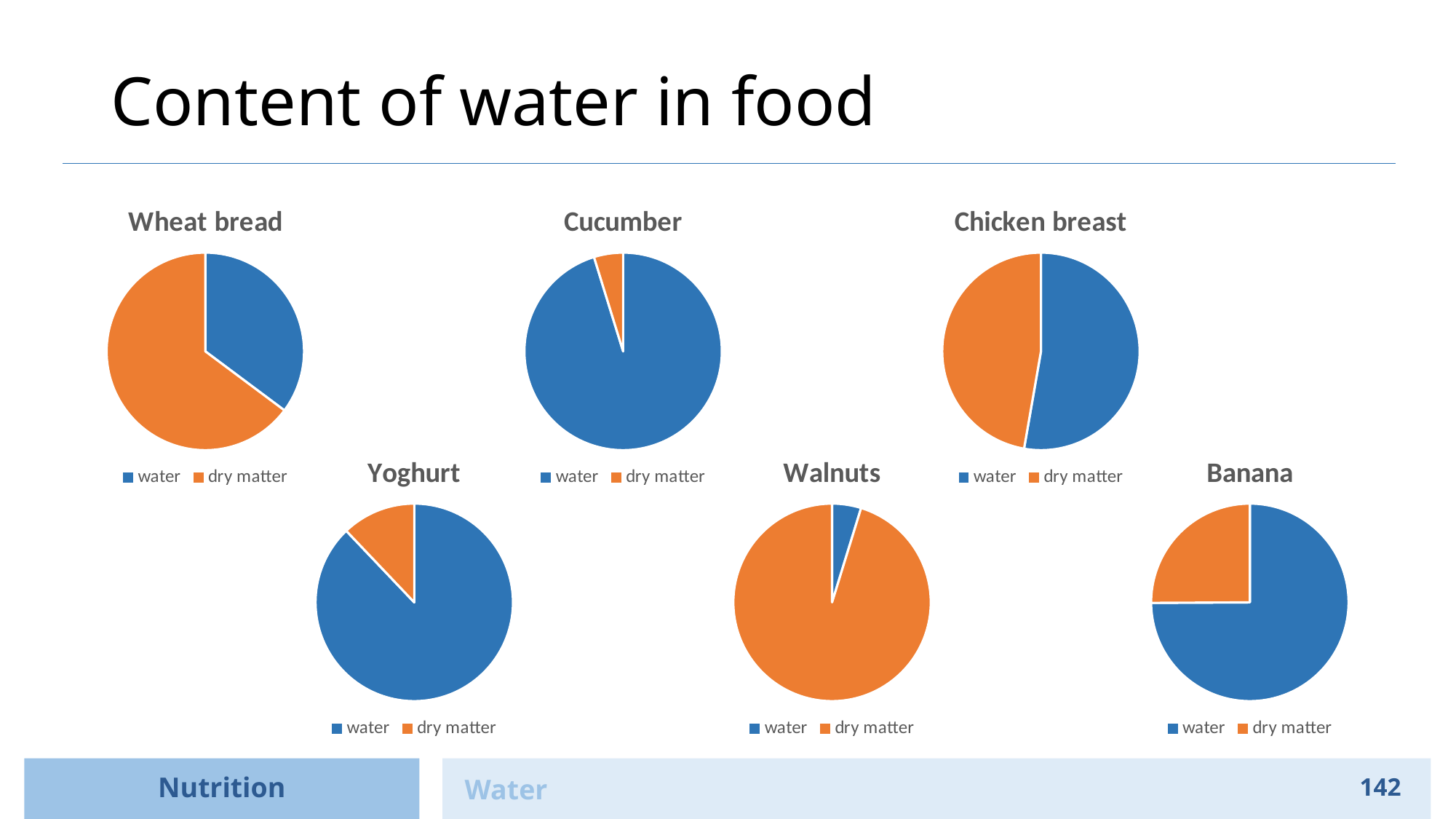
In the Walnuts chart, which slice is larger, water or dry matter? dry matter How many pie charts are shown on the slide? 6 In the Cucumber chart, which slice is larger, water or dry matter? water In the Banana chart, which slice is larger, water or dry matter? water Across the six pie charts, which food has the largest water share? Cucumber What kind of chart is used for the Wheat bread chart? pie chart How many slices does the Cucumber pie chart have? 2 How many entries does the legend of the Banana chart list? 2 Across the six pie charts, which food has the smallest water share? Walnuts What colour represents dry matter in the pie charts? orange